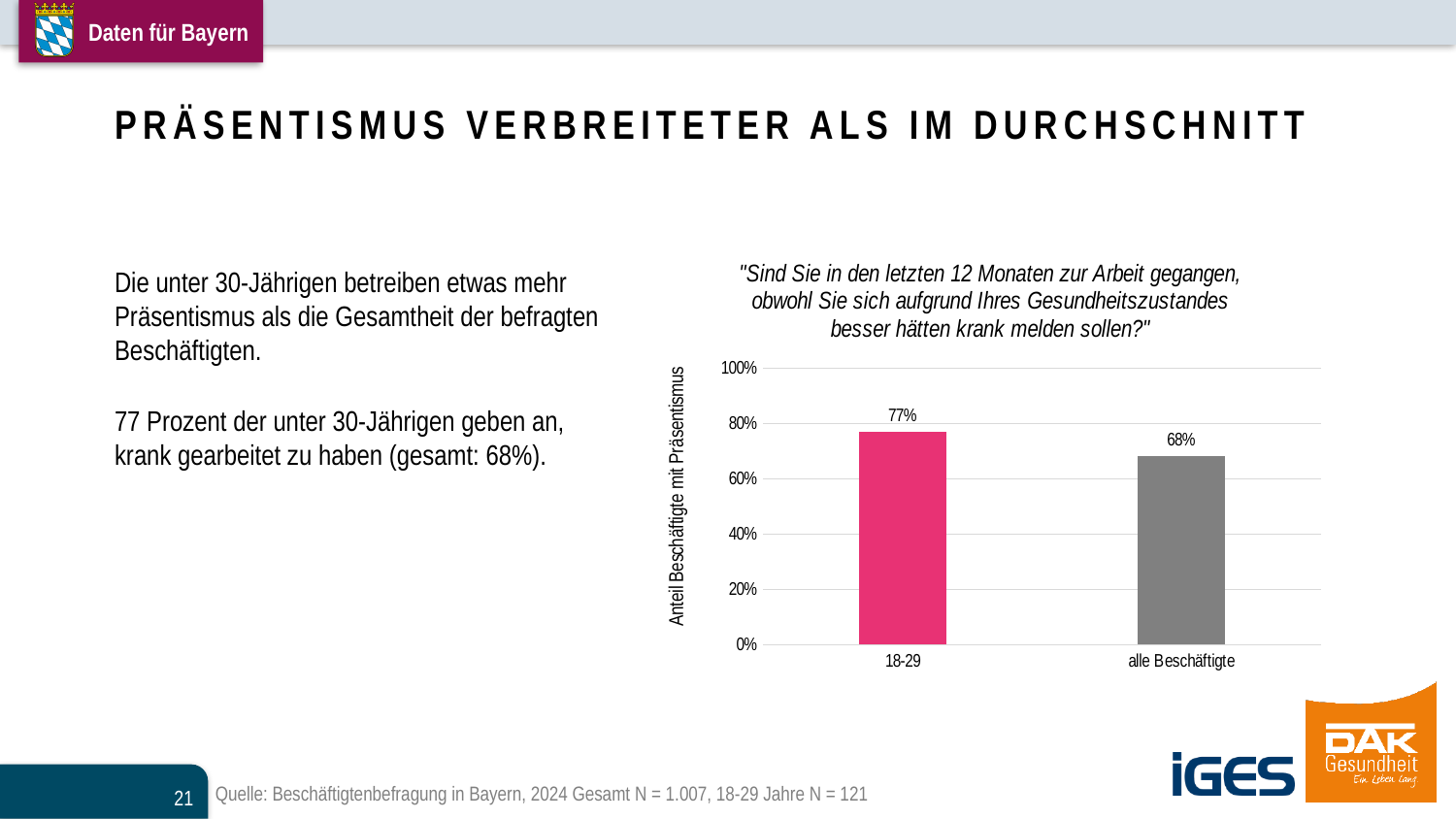
What is the label of the vertical axis? Anteil Beschäftigte mit Präsentismus What is the value for the 18-29 category? 77% What kind of chart is shown on the slide? bar chart Is the value for alle Beschäftigte greater or less than 60%? greater What colour is the bar for 18-29? pink Which category has the highest value? 18-29 How many categories are shown on the x axis? 2 Which is larger, the value for 18-29 or the value for alle Beschäftigte? 18-29 What is the difference between the value for 18-29 and the value for alle Beschäftigte? 9 percentage points Which category has the lowest value? alle Beschäftigte What is the value for alle Beschäftigte? 68% Is the value for 18-29 greater or less than 80%? less